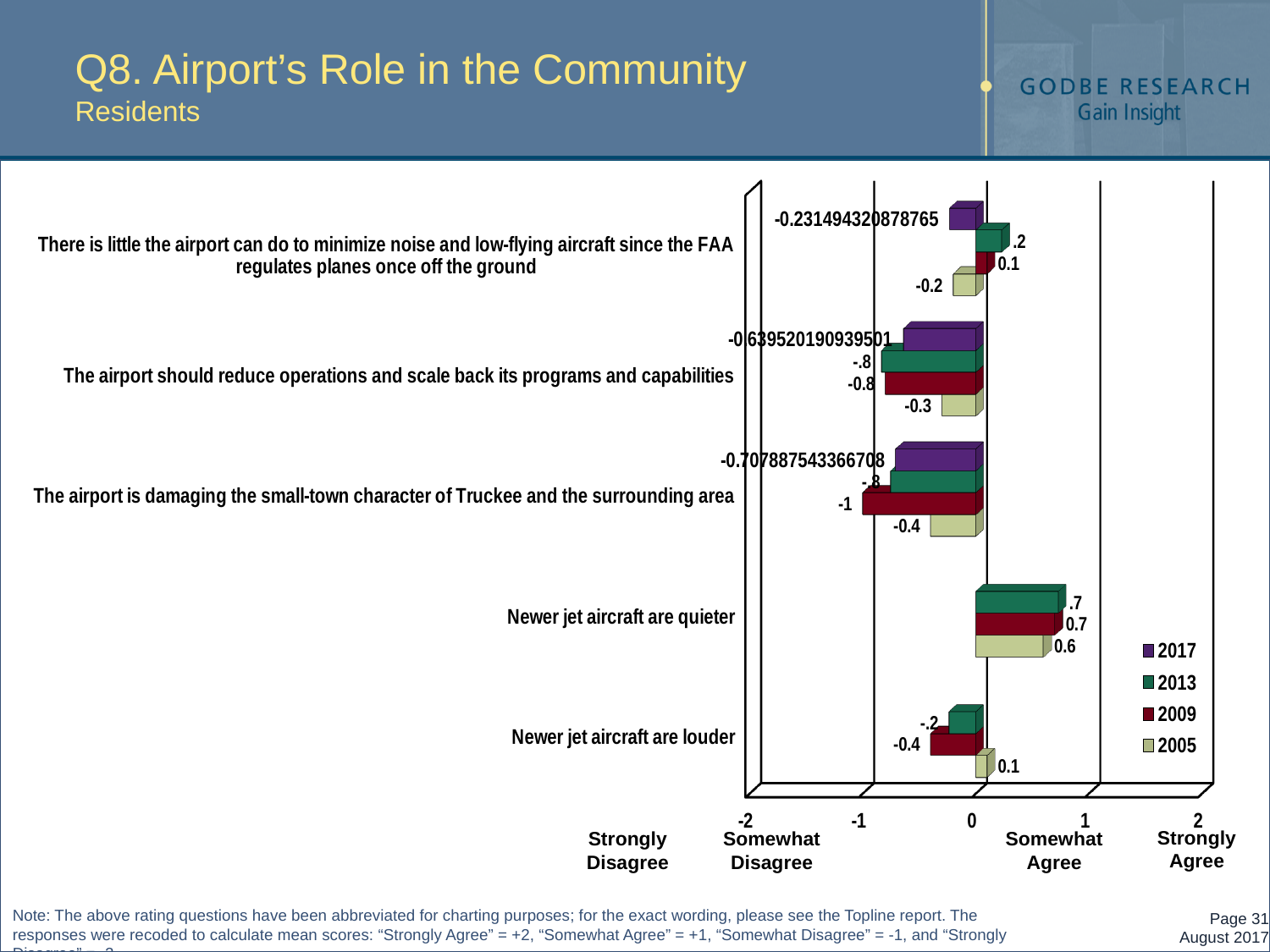
What is the 2005 value for "Newer jet aircraft are quieter"? 0.6 What is the difference between the 2009 value for "Newer jet aircraft are quieter" and the 2009 value for "Newer jet aircraft are louder"? 1.1 What is the 2009 value for "Newer jet aircraft are louder"? -0.4 What is the 2009 value for "The airport is damaging the small-town character of Truckee and the surrounding area"? -1 What kind of chart is shown on the slide? bar chart How many statement categories are plotted on the chart? 5 Which statement has the lowest 2009 value? The airport is damaging the small-town character of Truckee and the surrounding area How many series does the legend list? 4 Which statement has the highest 2005 value? Newer jet aircraft are quieter What is the 2005 value for "There is little the airport can do to minimize noise and low-flying aircraft since the FAA regulates planes once off the ground"? -0.2 For "Newer jet aircraft are louder", which is larger: the 2005 value or the 2009 value? 2005 What is the 2005 value for "The airport should reduce operations and scale back its programs and capabilities"? -0.3